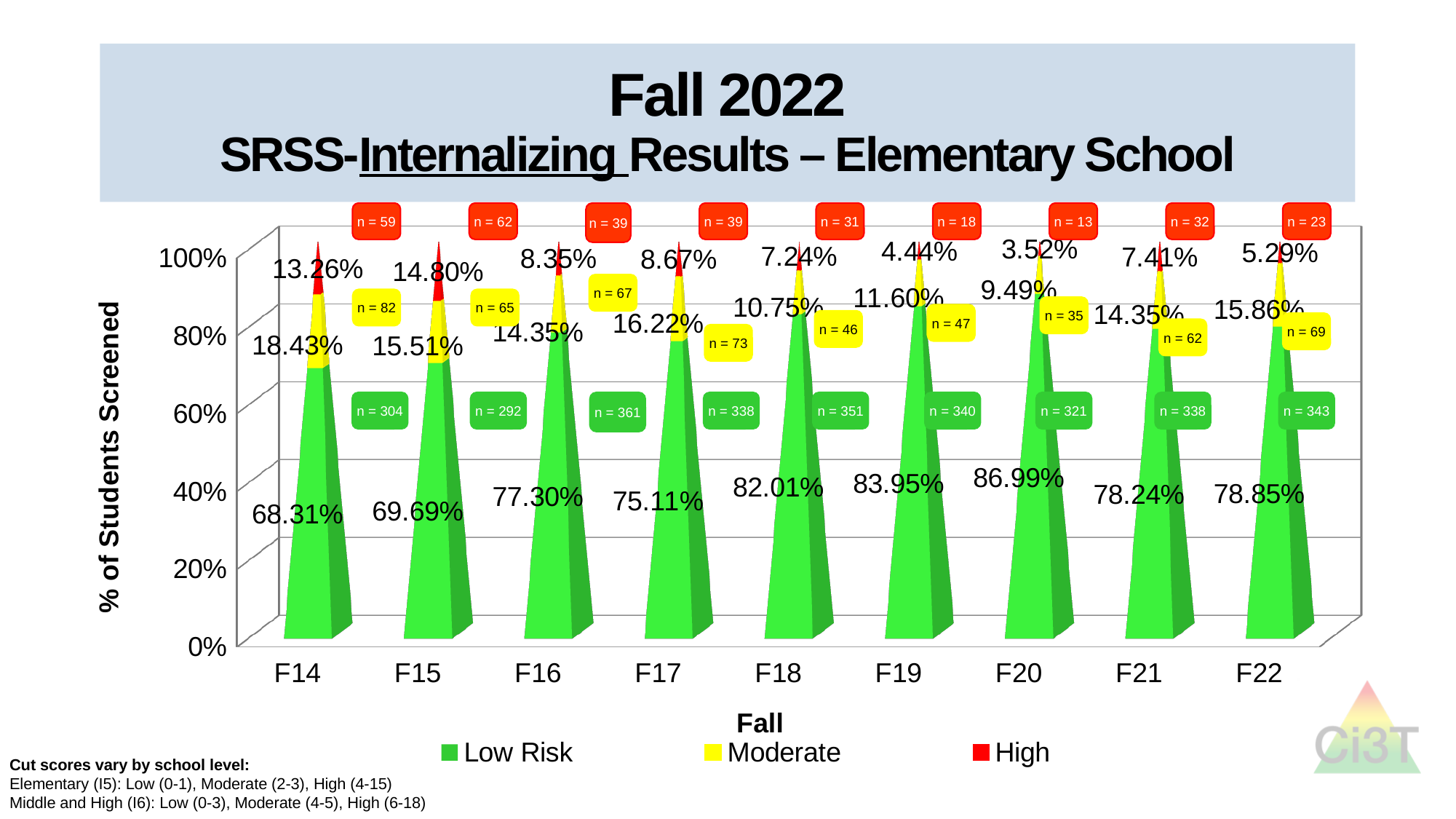
Which fall has the highest High percentage? F15 Is the Moderate percentage larger in F14 or F15? F14 What is the High percentage for F22? 5.29% Which fall has the lowest Low Risk percentage? F14 Which fall has the highest Low Risk percentage? F20 How many students were in the Low Risk group in F22 (the n value)? n = 343 How many fall screening periods are shown on the x axis? 9 How many series does the legend list? 3 Which fall has the lowest High percentage? F20 What percentage of students were Low Risk in F20? 86.99% What is the difference between the Low Risk percentages for F22 and F21? 0.61% What is the Moderate percentage for F17? 16.22%